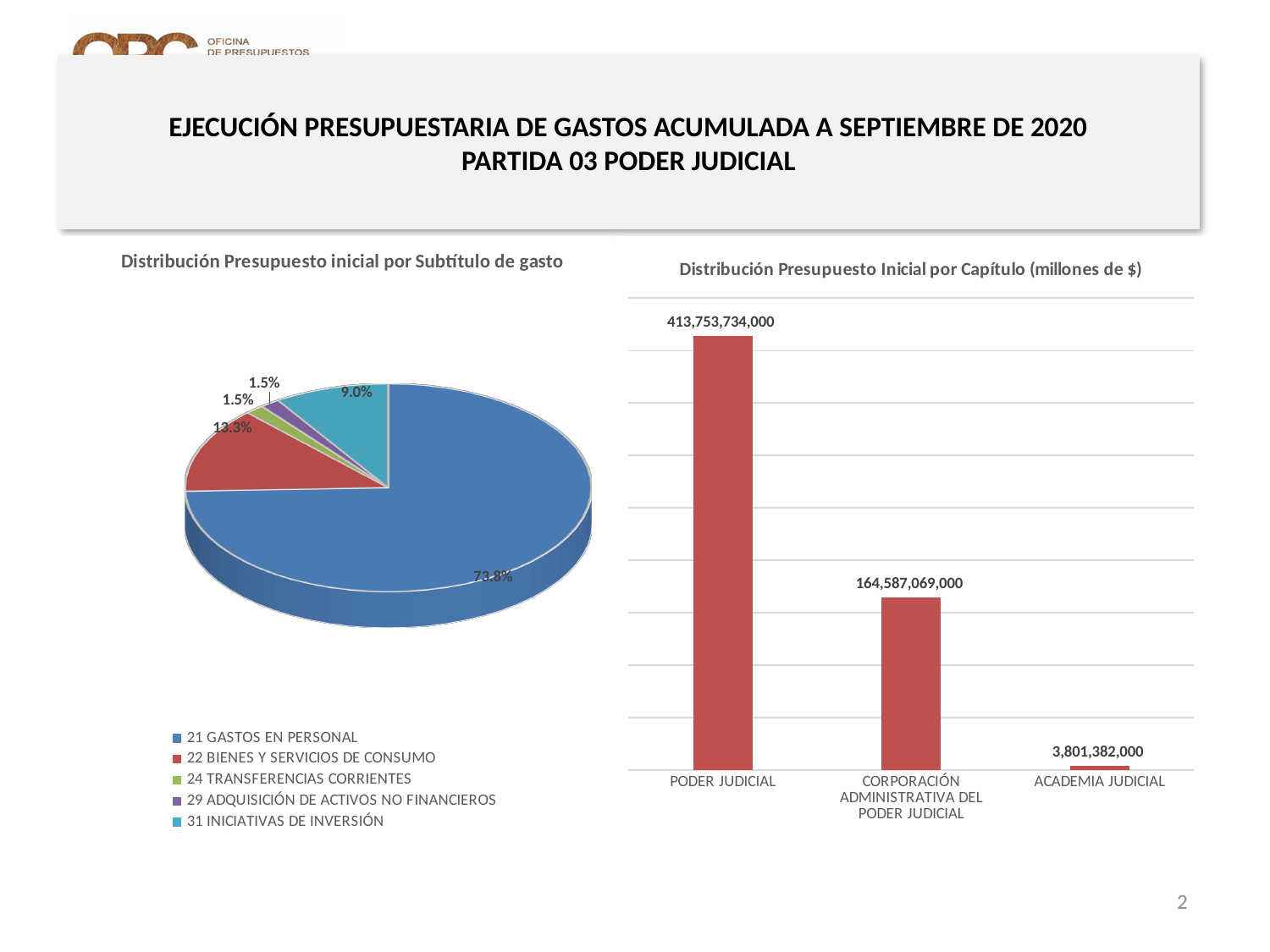
In the chart 'Distribución Presupuesto Inicial por Capítulo (millones de $)', what is the value for PODER JUDICIAL? 413,753,734,000 How many entries does the legend of the pie chart 'Distribución Presupuesto inicial por Subtítulo de gasto' list? 5 In the chart 'Distribución Presupuesto Inicial por Capítulo (millones de $)', what is the value for CORPORACIÓN ADMINISTRATIVA DEL PODER JUDICIAL? 164,587,069,000 In the chart 'Distribución Presupuesto Inicial por Capítulo (millones de $)', which category has the highest value? PODER JUDICIAL In the chart 'Distribución Presupuesto Inicial por Capítulo (millones de $)', which category has the lowest value? ACADEMIA JUDICIAL In the chart 'Distribución Presupuesto Inicial por Capítulo (millones de $)', what is the value for ACADEMIA JUDICIAL? 3,801,382,000 What kind of chart is 'Distribución Presupuesto Inicial por Capítulo (millones de $)'? Bar chart In the chart 'Distribución Presupuesto Inicial por Capítulo (millones de $)', how many categories are shown? 3 In the chart 'Distribución Presupuesto Inicial por Capítulo (millones de $)', what is the difference between the values for PODER JUDICIAL and CORPORACIÓN ADMINISTRATIVA DEL PODER JUDICIAL? 249,166,665,000 In the pie chart 'Distribución Presupuesto inicial por Subtítulo de gasto', what share does 22 BIENES Y SERVICIOS DE CONSUMO have? 13.3% In the pie chart 'Distribución Presupuesto inicial por Subtítulo de gasto', what share does 21 GASTOS EN PERSONAL have? 73.8% In the pie chart 'Distribución Presupuesto inicial por Subtítulo de gasto', what share does 31 INICIATIVAS DE INVERSIÓN have? 9.0%